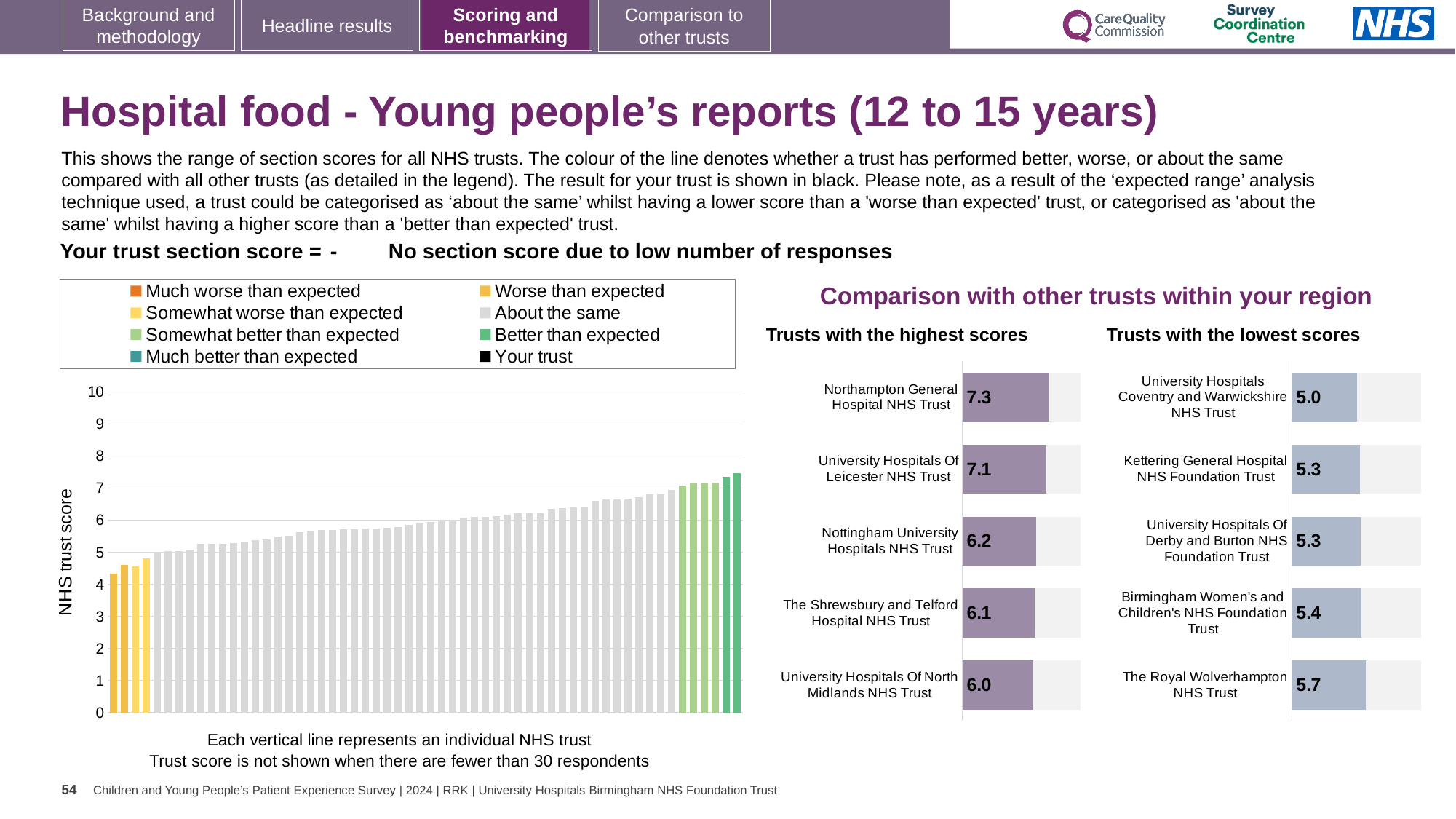
In the 'Trusts with the lowest scores' chart, what is the difference between the scores of The Royal Wolverhampton NHS Trust and University Hospitals Coventry and Warwickshire NHS Trust? 0.7 In the 'Trusts with the highest scores' chart, what is the difference between the scores of Northampton General Hospital NHS Trust and University Hospitals Of North Midlands NHS Trust? 1.3 What kind of chart is the large chart on the left showing NHS trust scores? Bar chart In the 'Trusts with the highest scores' chart, which trust has the highest score? Northampton General Hospital NHS Trust How many trusts are listed in the 'Trusts with the lowest scores' chart? 5 How many entries does the legend above the large chart on the left list? 8 In the large chart on the left, do the NHS trust scores rise or fall from left to right? Rise In the 'Trusts with the lowest scores' chart, which trust has the lowest score? University Hospitals Coventry and Warwickshire NHS Trust In the 'Trusts with the highest scores' chart, what is the score for Northampton General Hospital NHS Trust? 7.3 In the 'Trusts with the highest scores' chart, which has the larger score: University Hospitals Of Leicester NHS Trust or The Shrewsbury and Telford Hospital NHS Trust? University Hospitals Of Leicester NHS Trust In the 'Trusts with the highest scores' chart, what is the score for Nottingham University Hospitals NHS Trust? 6.2 In the 'Trusts with the lowest scores' chart, what is the score for The Royal Wolverhampton NHS Trust? 5.7